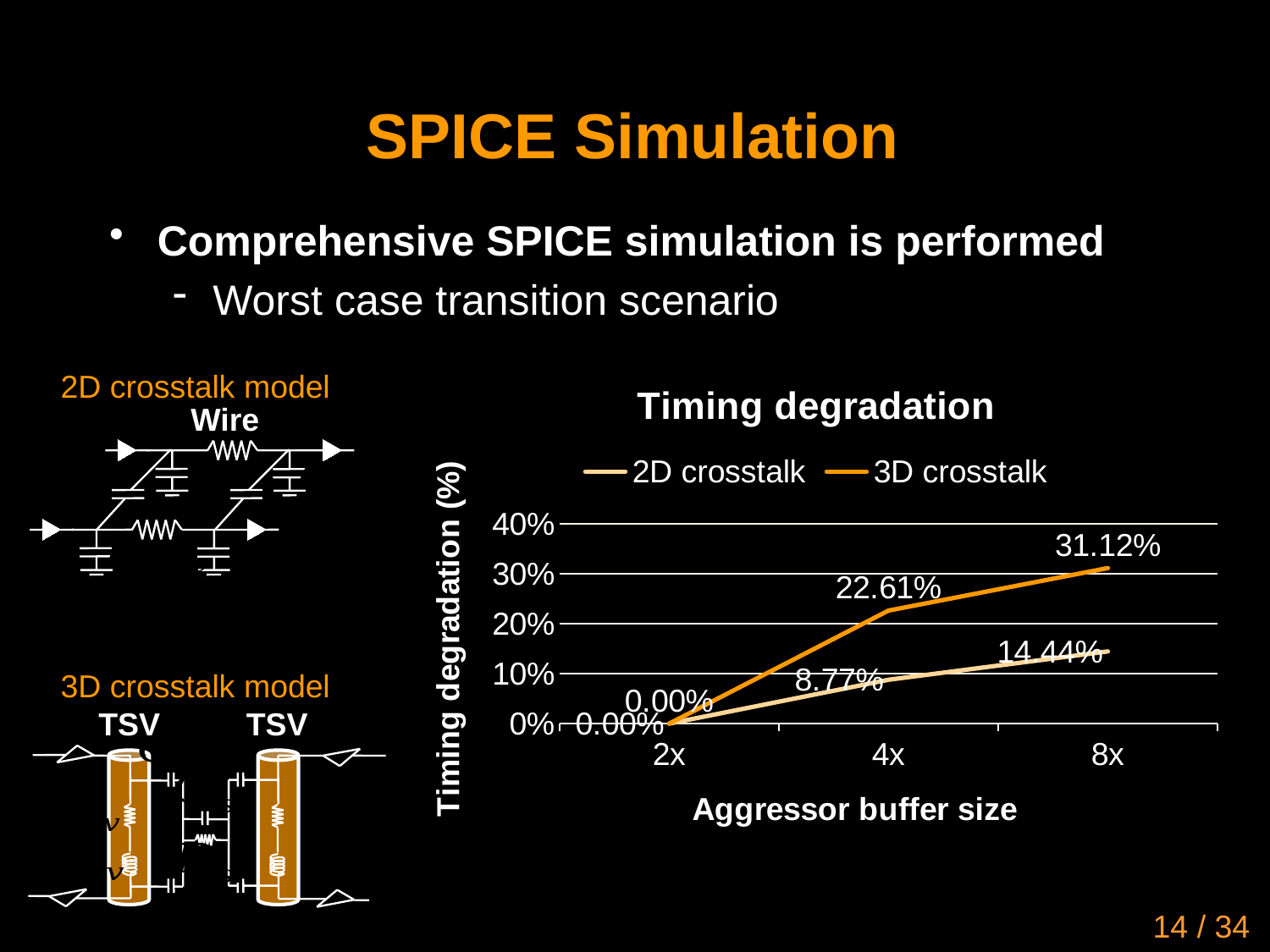
What is the difference between the 3D crosstalk and 2D crosstalk timing degradation at an aggressor buffer size of 4x? 13.84% What is the timing degradation for 2D crosstalk at an aggressor buffer size of 8x? 14.44% Which series has the larger timing degradation at an aggressor buffer size of 8x, 2D crosstalk or 3D crosstalk? 3D crosstalk Does the timing degradation for 3D crosstalk rise or fall as the aggressor buffer size increases from 2x to 8x? rise What is the title of the chart? Timing degradation What is the timing degradation for 2D crosstalk at an aggressor buffer size of 4x? 8.77% How many aggressor buffer sizes are plotted on the x axis? 3 What is the timing degradation for 3D crosstalk at an aggressor buffer size of 8x? 31.12% What is the timing degradation for 3D crosstalk at an aggressor buffer size of 4x? 22.61% At which aggressor buffer size is the 3D crosstalk timing degradation highest? 8x What type of chart is shown on the slide? line chart How many series does the chart legend list? 2